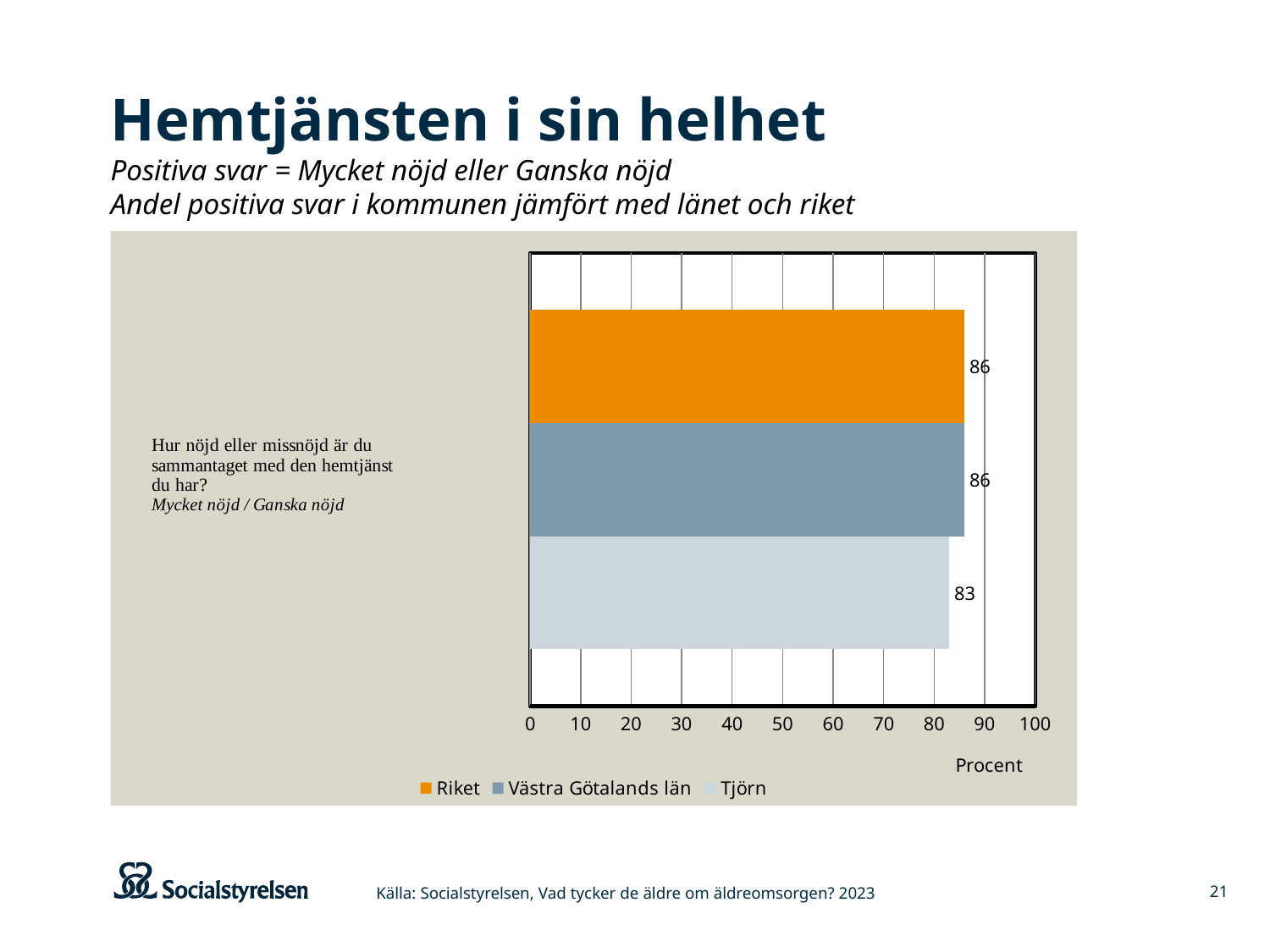
What is the difference between the value for Riket and the value for Tjörn? 3 What kind of chart is shown on the slide? bar chart What unit is shown on the x axis label? Procent Which is larger, the value for Riket or the value for Tjörn? Riket What is the value for Riket? 86 What is the value for Västra Götalands län? 86 Is the value for Riket greater or less than 80? greater What is the value for Tjörn? 83 How many series does the legend list? 3 What is the difference between the value for Västra Götalands län and the value for Tjörn? 3 Which series has the lowest value? Tjörn Is the value for Tjörn greater or less than 90? less